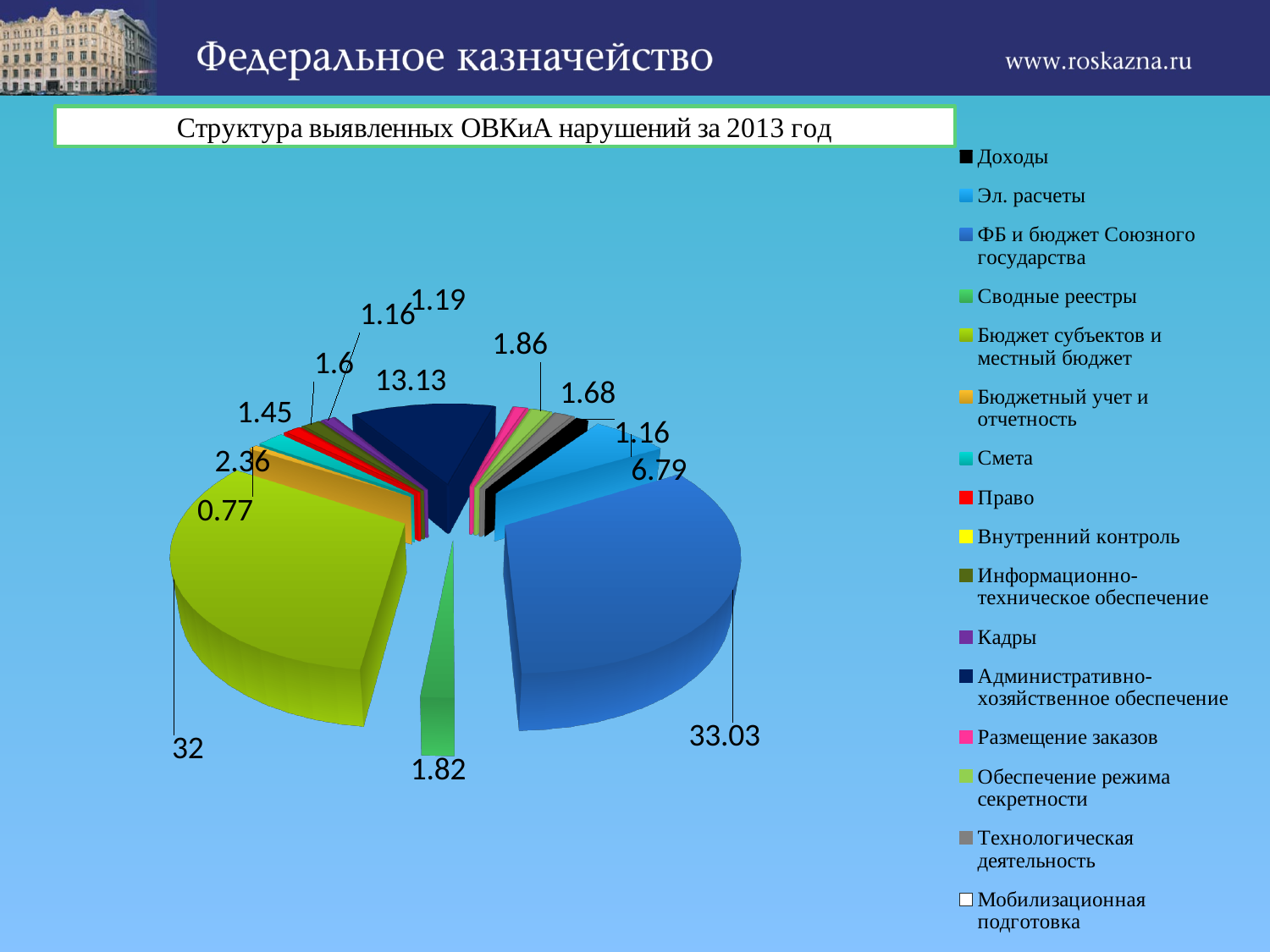
How many categories does the legend list? 16 What is the difference between the two largest values, 33.03 and 32? 1.03 What is the smallest value labelled on the pie chart? 0.77 What is the value for Эл. расчеты? 6.79 What is the value for Бюджет субъектов и местный бюджет? 32 What is the title of the chart? Структура выявленных ОВКиА нарушений за 2013 год What kind of chart is shown on the slide? pie chart Which is larger: the slice for ФБ и бюджет Союзного государства or the slice for Бюджет субъектов и местный бюджет? ФБ и бюджет Союзного государства Which category has the largest slice of the pie? ФБ и бюджет Союзного государства What is the largest value labelled on the pie chart? 33.03 What is the value for Административно-хозяйственное обеспечение? 13.13 What is the value for Сводные реестры? 1.82